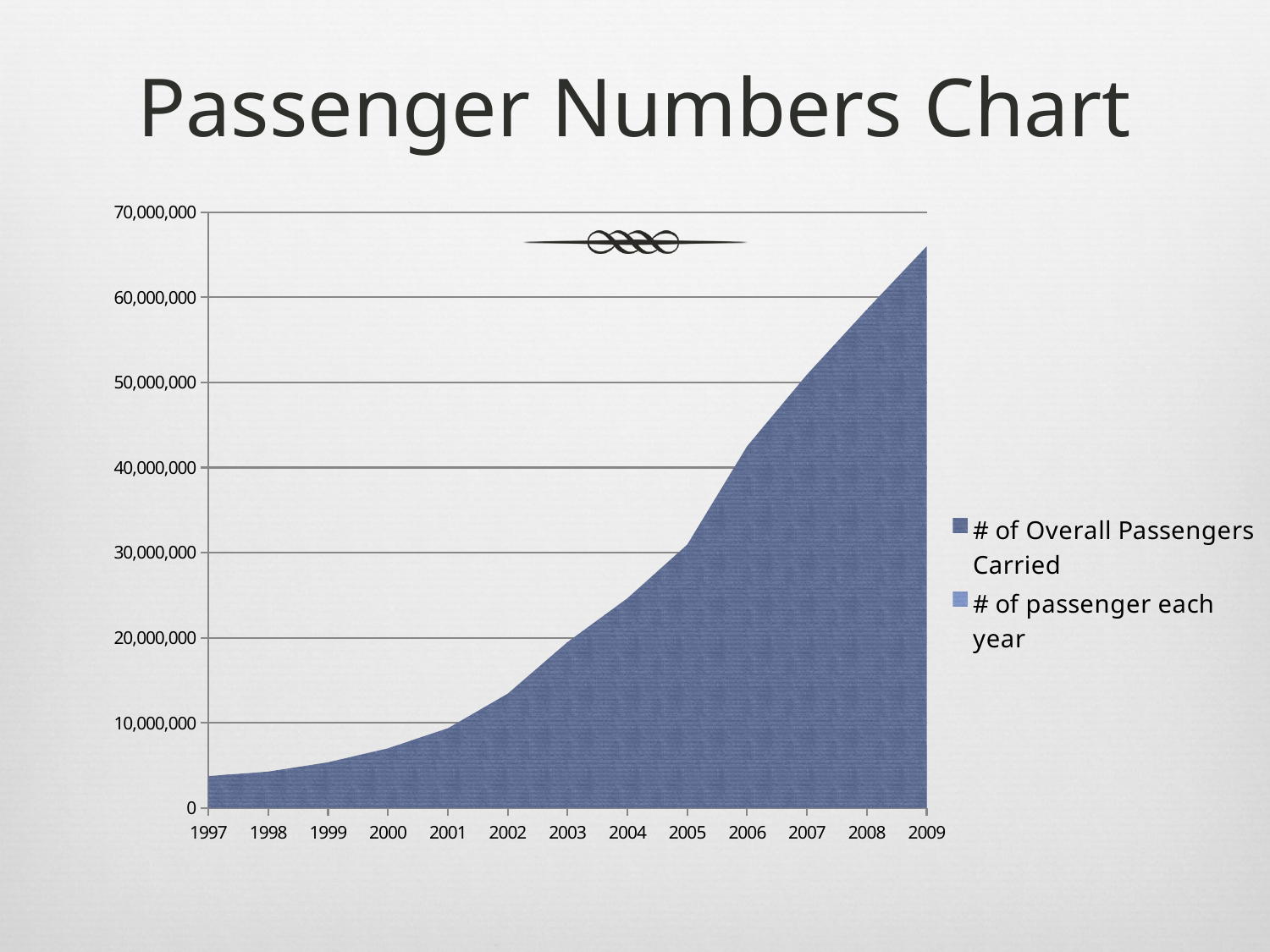
Which is larger, the value for overall passengers carried in 2008 or in 2004? 2008 Is the value for overall passengers carried in 2002 greater or less than 20,000,000? less Which year has the lowest number of overall passengers carried? 1997 Which year has the highest number of overall passengers carried? 2009 How many years are shown along the x axis? 13 Is the value for overall passengers carried in 1997 greater or less than 10,000,000? less How many series does the legend list? 2 What kind of chart is shown on the slide? Area chart Is the value for overall passengers carried in 2006 greater or less than 40,000,000? greater What is the title of the chart? Passenger Numbers Chart Do the values for overall passengers carried rise or fall from 1997 to 2009? Rise